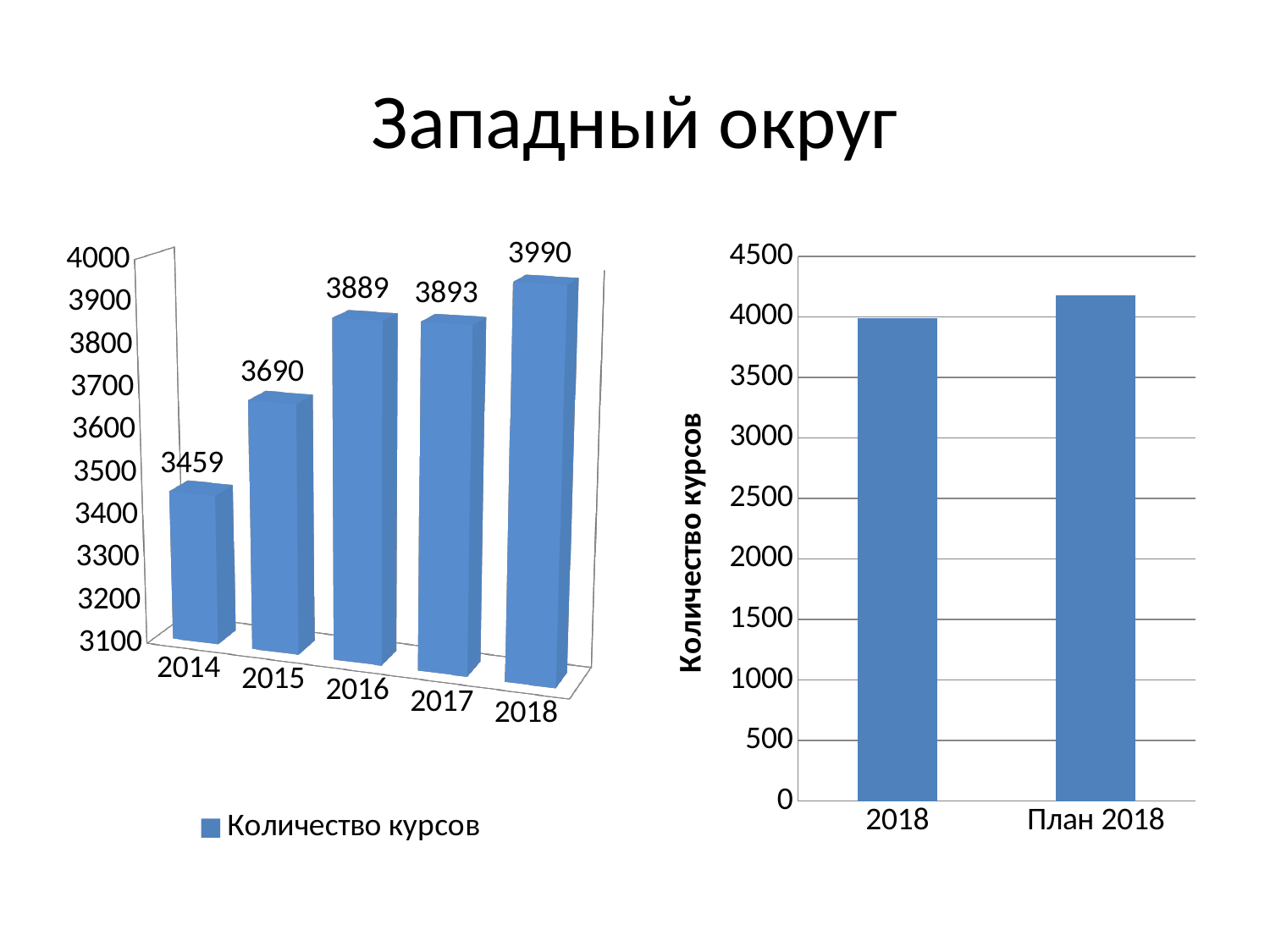
In the left chart, which year has the lowest value? 2014 In the left chart, do the values generally rise or fall from 2014 to 2018? rise In the left chart, what is the value for 2016? 3889 In the right chart, which is larger, the value for 2018 or the value for План 2018? План 2018 In the left chart, what is the value for 2018? 3990 In the left chart, which year has the highest value? 2018 In the left chart, which is larger, the value for 2015 or the value for 2016? 2016 In the right chart, is the value for План 2018 greater or less than 4000? greater In the left chart, how many years are shown on the x axis? 5 In the left chart, what is the difference between the values for 2015 and 2014? 231 In the left chart, what is the difference between the values for 2018 and 2014? 531 In the left chart, what is the value for 2014? 3459